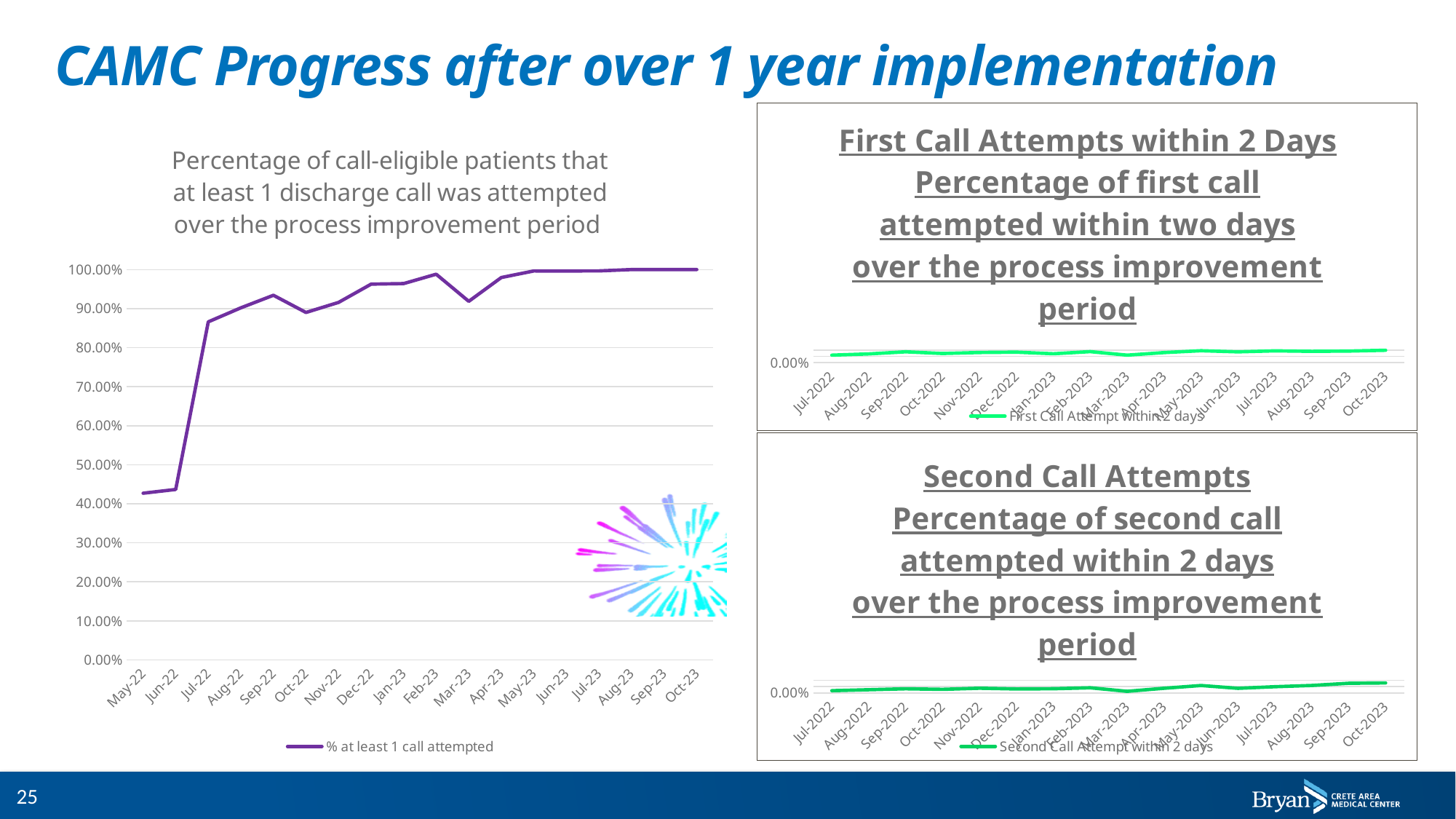
On the left chart, do the values generally rise or fall from May-22 to Oct-23? rise On the 'Second Call Attempts' chart, what is the legend entry for the plotted line? Second Call Attempt within 2 days On the left chart, which is larger, the value for Jun-22 or the value for Jul-22? Jul-22 What kind of chart is the 'Second Call Attempts' chart on the lower right? line chart On the left chart, is the value for May-22 greater or less than 50.00%? less On the left chart, how many months are shown along the x axis? 18 On the left chart, is the value for Jul-22 greater or less than 80.00%? greater On the left chart, how many series does the legend list? 1 On the left chart, what is the legend entry for the plotted line? % at least 1 call attempted On the 'First Call Attempts within 2 Days' chart, how many months are shown along the x axis? 16 What kind of chart is the left chart titled 'Percentage of call-eligible patients that at least 1 discharge call was attempted over the process improvement period'? line chart On the left chart, is the value for Oct-23 greater or less than 90.00%? greater